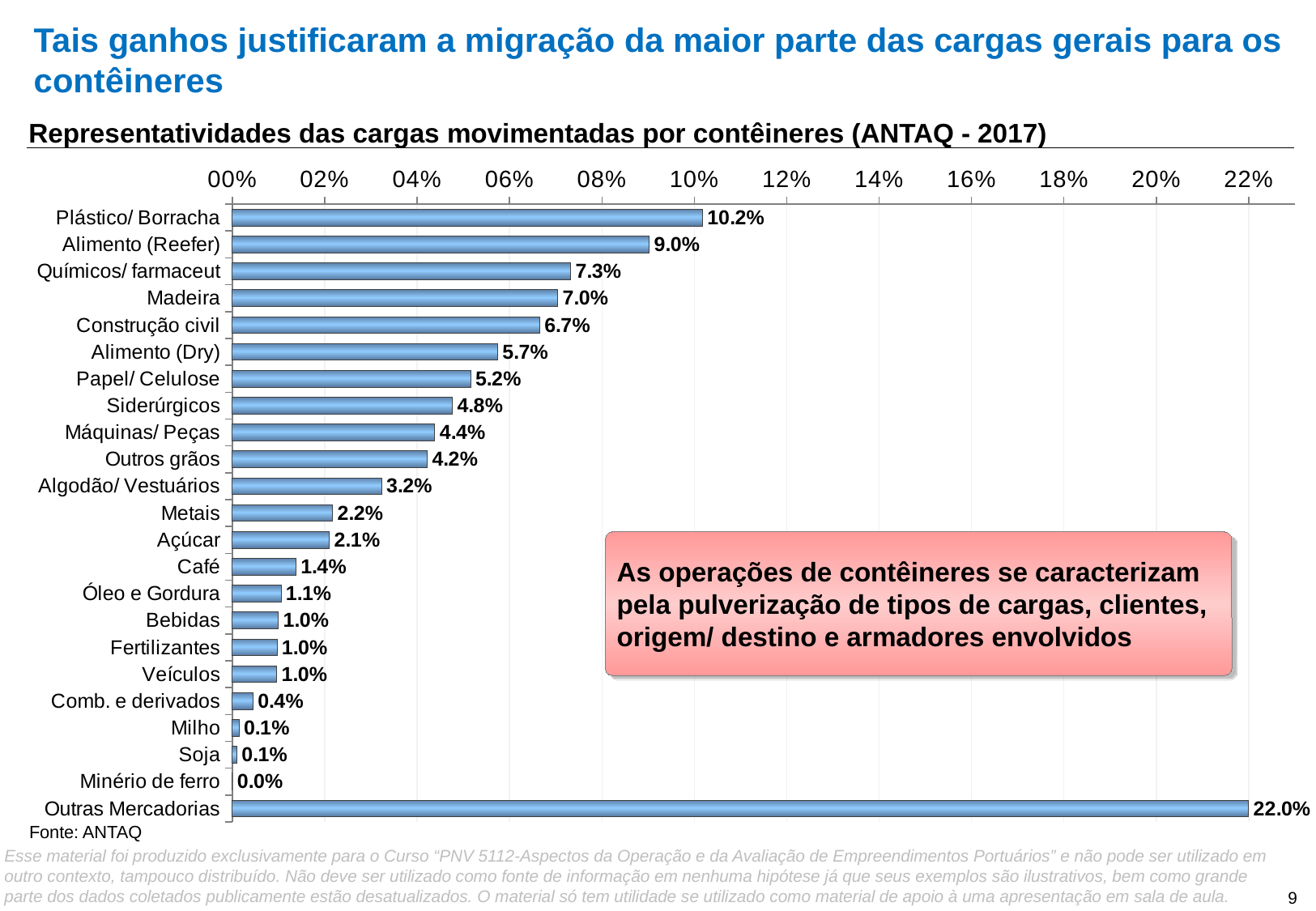
What is the title of the chart? Representatividades das cargas movimentadas por contêineres (ANTAQ - 2017) What is the total of the values for Milho and Soja? 0.2% What is the value for Madeira? 7.0% What type of chart is shown on the slide? Bar chart What is the value for Algodão/ Vestuários? 3.2% Which category has the lowest value? Minério de ferro What is the value for Café? 1.4% Which category has the highest value? Outras Mercadorias What is the difference between the values for Plástico/ Borracha and Alimento (Reefer)? 1.2% How many categories are shown in the chart? 23 Which is larger, the value for Siderúrgicos or the value for Outros grãos? Siderúrgicos What is the value for Plástico/ Borracha? 10.2%